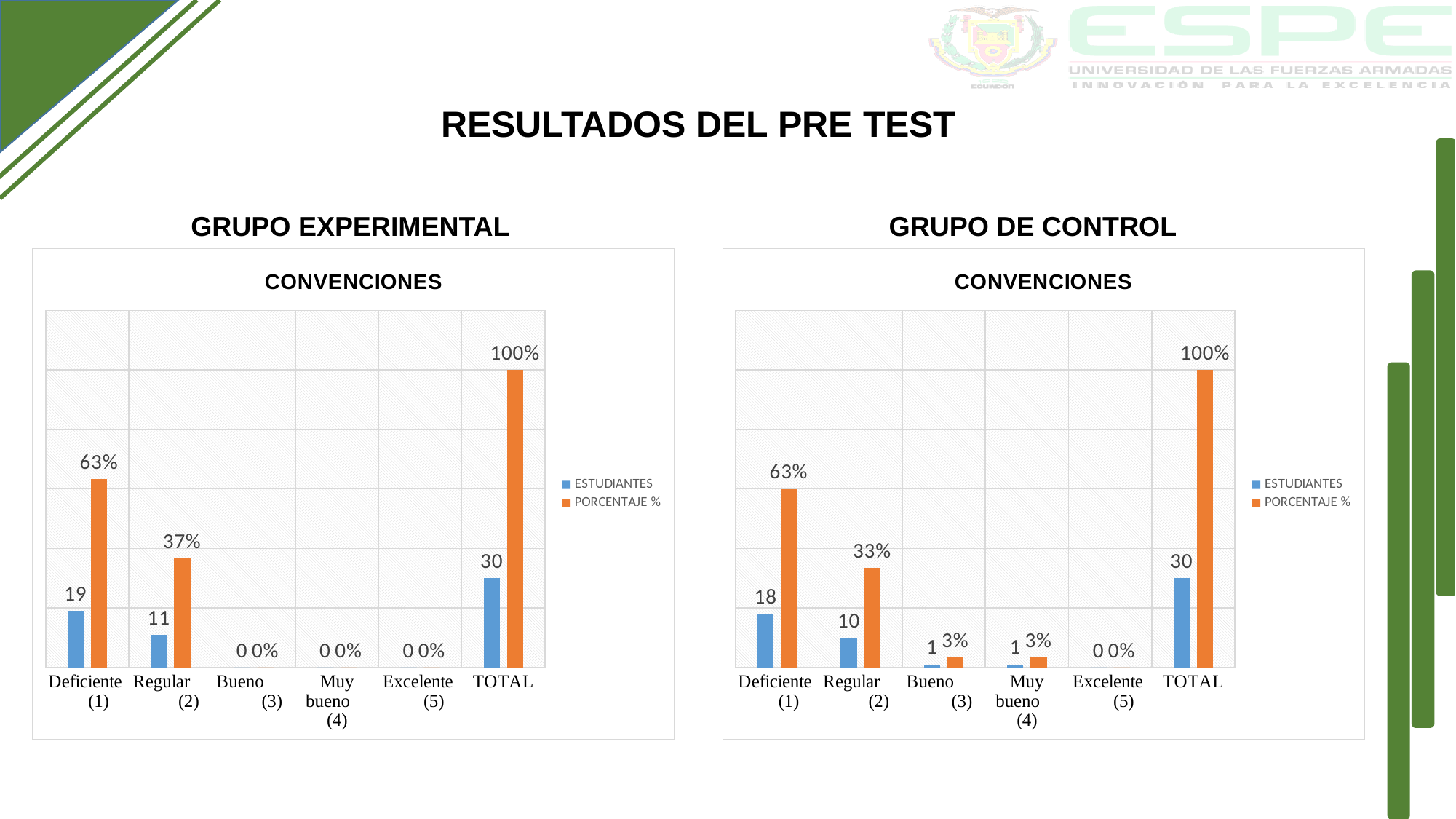
In the GRUPO EXPERIMENTAL chart, which category other than TOTAL has the highest ESTUDIANTES value? Deficiente (1) In the GRUPO DE CONTROL chart, what is the PORCENTAJE % value for Bueno (3)? 3% Which chart has the larger ESTUDIANTES value for Deficiente (1), GRUPO EXPERIMENTAL or GRUPO DE CONTROL? GRUPO EXPERIMENTAL In the GRUPO EXPERIMENTAL chart, what is the difference between the ESTUDIANTES values for Deficiente (1) and Regular (2)? 8 What kind of chart is the GRUPO DE CONTROL chart? Bar chart In the GRUPO DE CONTROL chart, what is the difference between the PORCENTAJE % values for Deficiente (1) and Regular (2)? 30% In the GRUPO EXPERIMENTAL chart, what is the PORCENTAJE % value for Regular (2)? 37% How many series does the legend of the GRUPO EXPERIMENTAL chart list? 2 In the GRUPO DE CONTROL chart, which category has the lowest ESTUDIANTES value? Excelente (5) In the GRUPO EXPERIMENTAL chart, what is the ESTUDIANTES value for Deficiente (1)? 19 How many categories are shown on the x axis of the GRUPO DE CONTROL chart? 6 In the GRUPO DE CONTROL chart, what is the ESTUDIANTES value for Regular (2)? 10